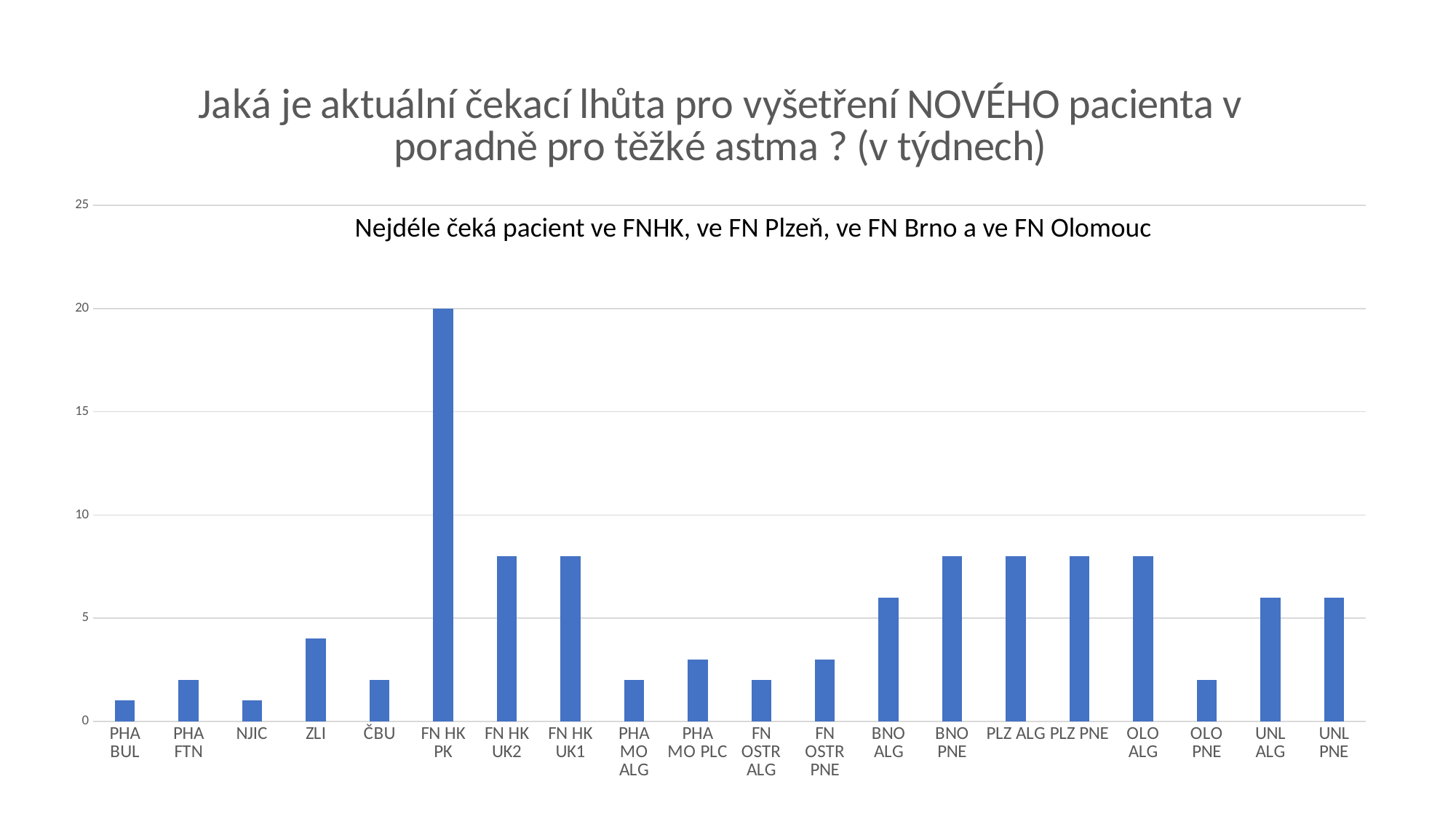
What is the value for FN HK PK? 20 Which is larger, the value for BNO PNE or the value for OLO PNE? BNO PNE What type of chart is shown on the slide? bar chart Is the value for BNO PNE greater or less than 5? greater How many categories are shown on the x axis? 20 What is the title of the chart? Jaká je aktuální čekací lhůta pro vyšetření NOVÉHO pacienta v poradně pro těžké astma ? (v týdnech) Is the value for FN HK UK2 greater or less than 10? less Which category has the highest value? FN HK PK Is the value for PHA BUL greater or less than 5? less Which is larger, the value for FN HK PK or the value for ZLI? FN HK PK